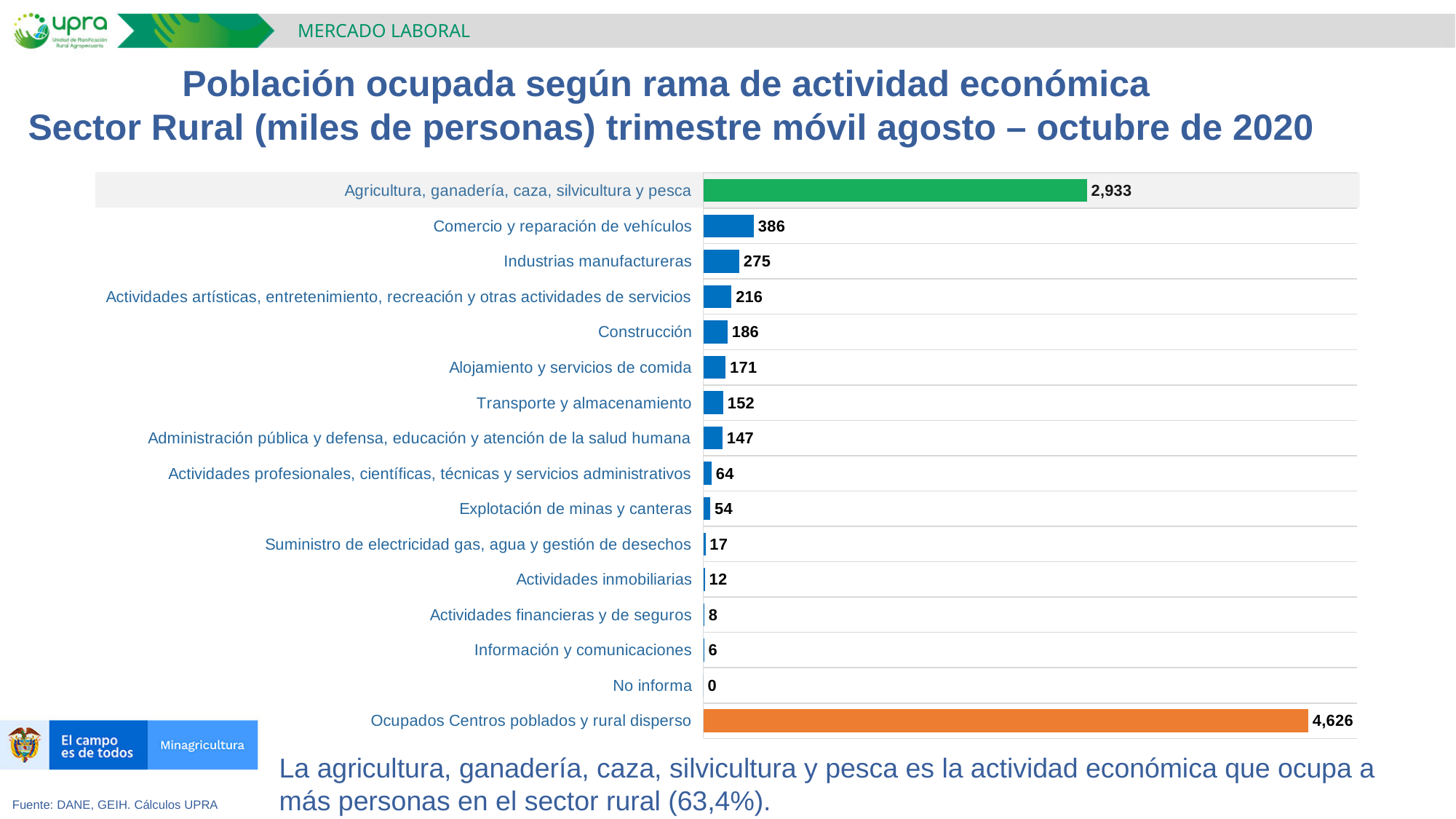
What colour is the bar for Ocupados Centros poblados y rural disperso? Orange Which category has the highest value on the chart? Ocupados Centros poblados y rural disperso Which is larger, the value for Transporte y almacenamiento or the value for Alojamiento y servicios de comida? Alojamiento y servicios de comida What is the value for Agricultura, ganadería, caza, silvicultura y pesca? 2,933 How many categories are shown on the chart? 16 What kind of chart is shown on the slide? Bar chart What is the value for Explotación de minas y canteras? 54 What is the value for Ocupados Centros poblados y rural disperso? 4,626 What is the difference between the values for Comercio y reparación de vehículos and Industrias manufactureras? 111 What is the value for Construcción? 186 Which category has the lowest value on the chart? No informa What is the value for Comercio y reparación de vehículos? 386